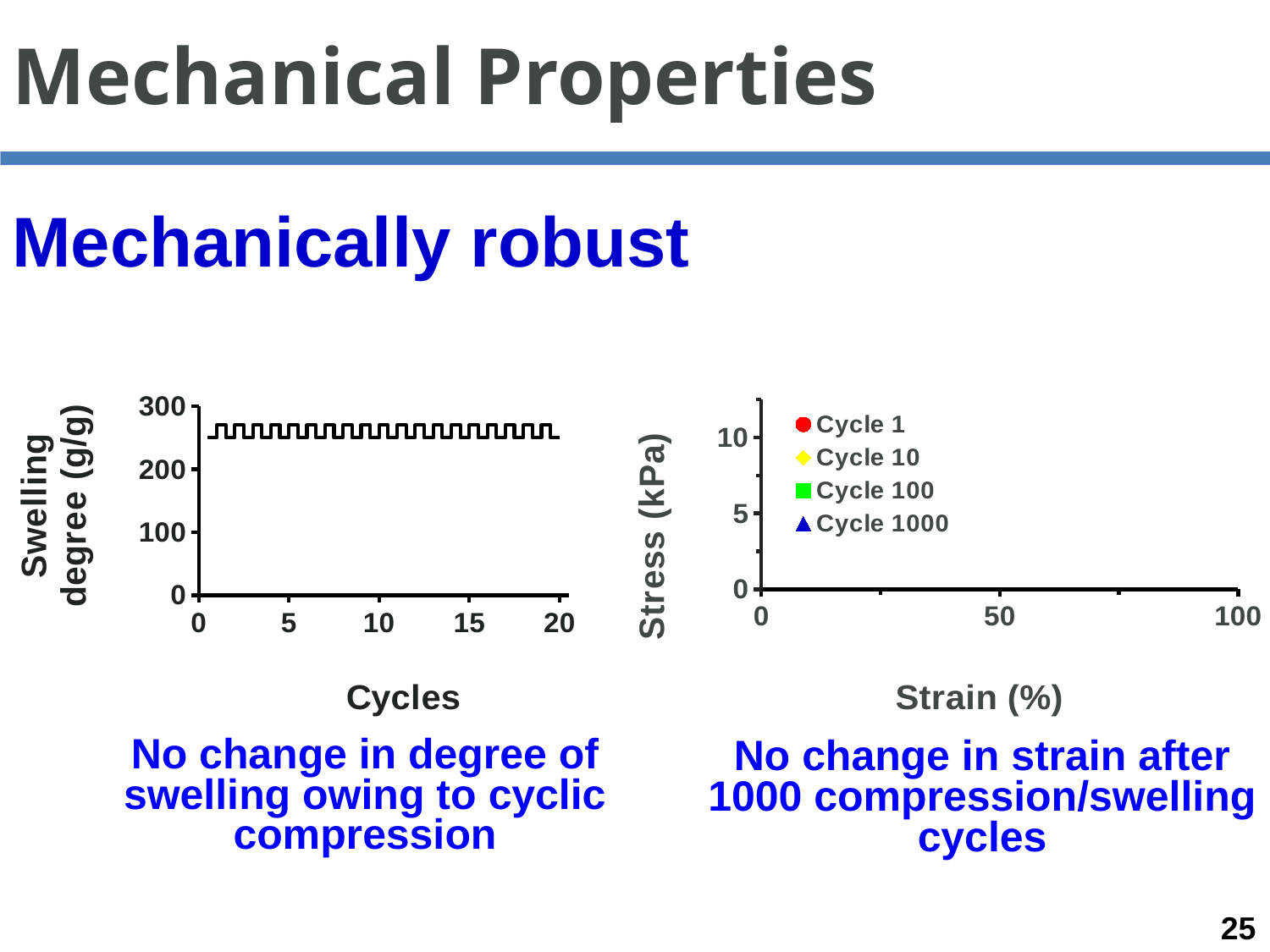
In the left chart (Swelling degree vs Cycles), is the swelling degree greater or less than 200 g/g across the cycles? greater In the right chart (Stress vs Strain), what is the highest value shown on the x axis? 100 In the left chart (Swelling degree vs Cycles), is the swelling degree greater or less than 300 g/g across the cycles? less In the right chart (Stress vs Strain), which series is listed first in the legend? Cycle 1 In the left chart (Swelling degree vs Cycles), what kind of chart is it? line chart In the left chart (Swelling degree vs Cycles), does the swelling degree rise, fall, or stay roughly constant as the number of cycles increases? stays roughly constant In the left chart (Swelling degree vs Cycles), what is the highest value shown on the y axis? 300 In the right chart (Stress vs Strain), how many series does the legend list? 4